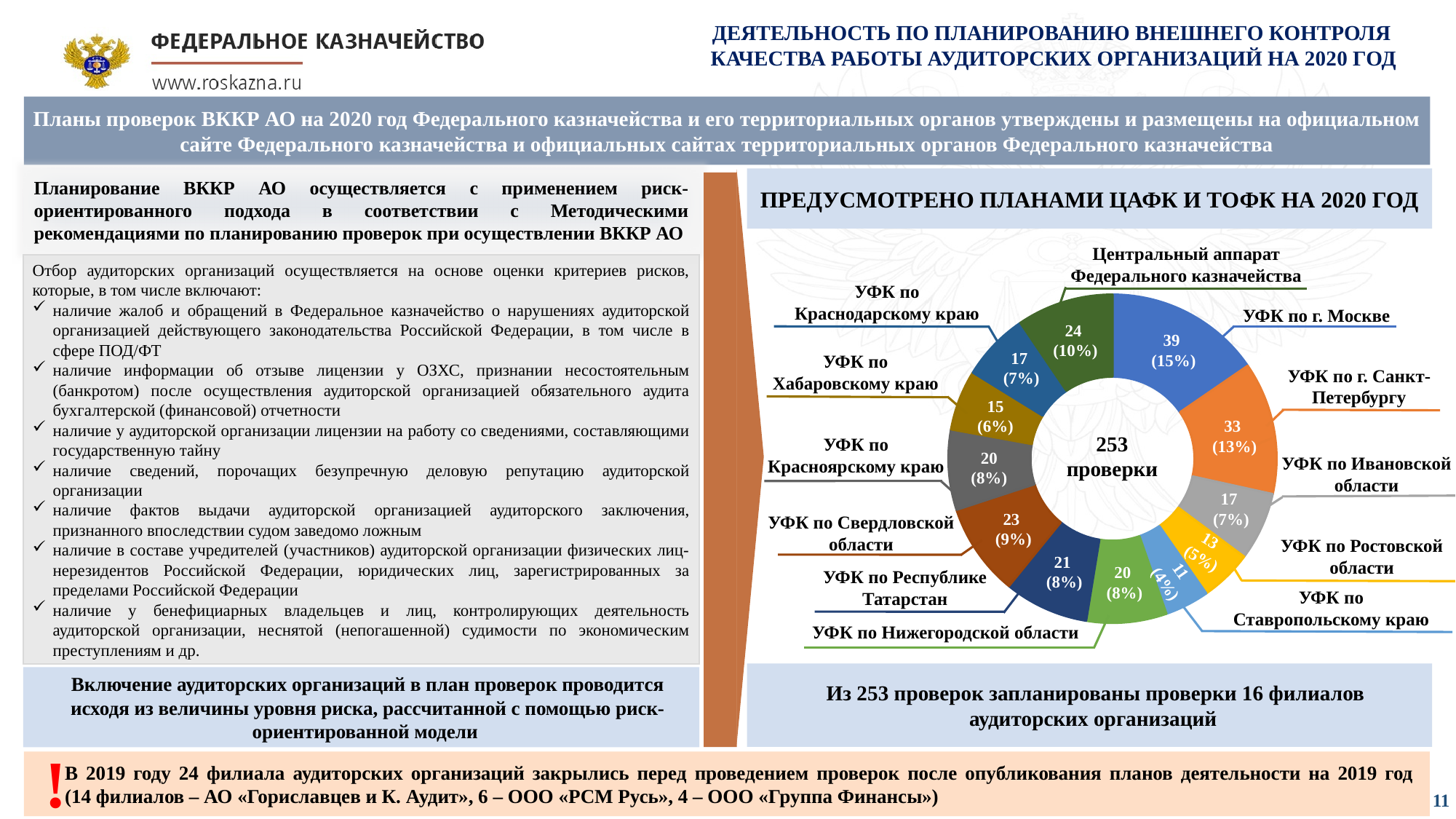
Как называется диаграмма на слайде? Предусмотрено планами ЦАФК и ТОФК на 2020 год На сколько проверок больше у УФК по г. Москве, чем у УФК по г. Санкт-Петербургу? 6 У какого органа наибольшее число запланированных проверок? УФК по г. Москве Какой тип диаграммы показан на слайде? Кольцевая (круговая) диаграмма Где запланировано больше проверок: в УФК по Республике Татарстан или в УФК по Хабаровскому краю? УФК по Республике Татарстан Сколько проверок предусмотрено планами для УФК по г. Москве? 39 (15%) Какое общее число проверок указано в центре диаграммы? 253 проверки У какого органа наименьшее число запланированных проверок? УФК по Ставропольскому краю Сколько проверок запланировано для УФК по Свердловской области? 23 (9%) Сколько проверок предусмотрено для Центрального аппарата Федерального казначейства? 24 (10%) Сколько сегментов (органов) показано на диаграмме? 12 Какая доля проверок приходится на УФК по Ставропольскому краю? 4%